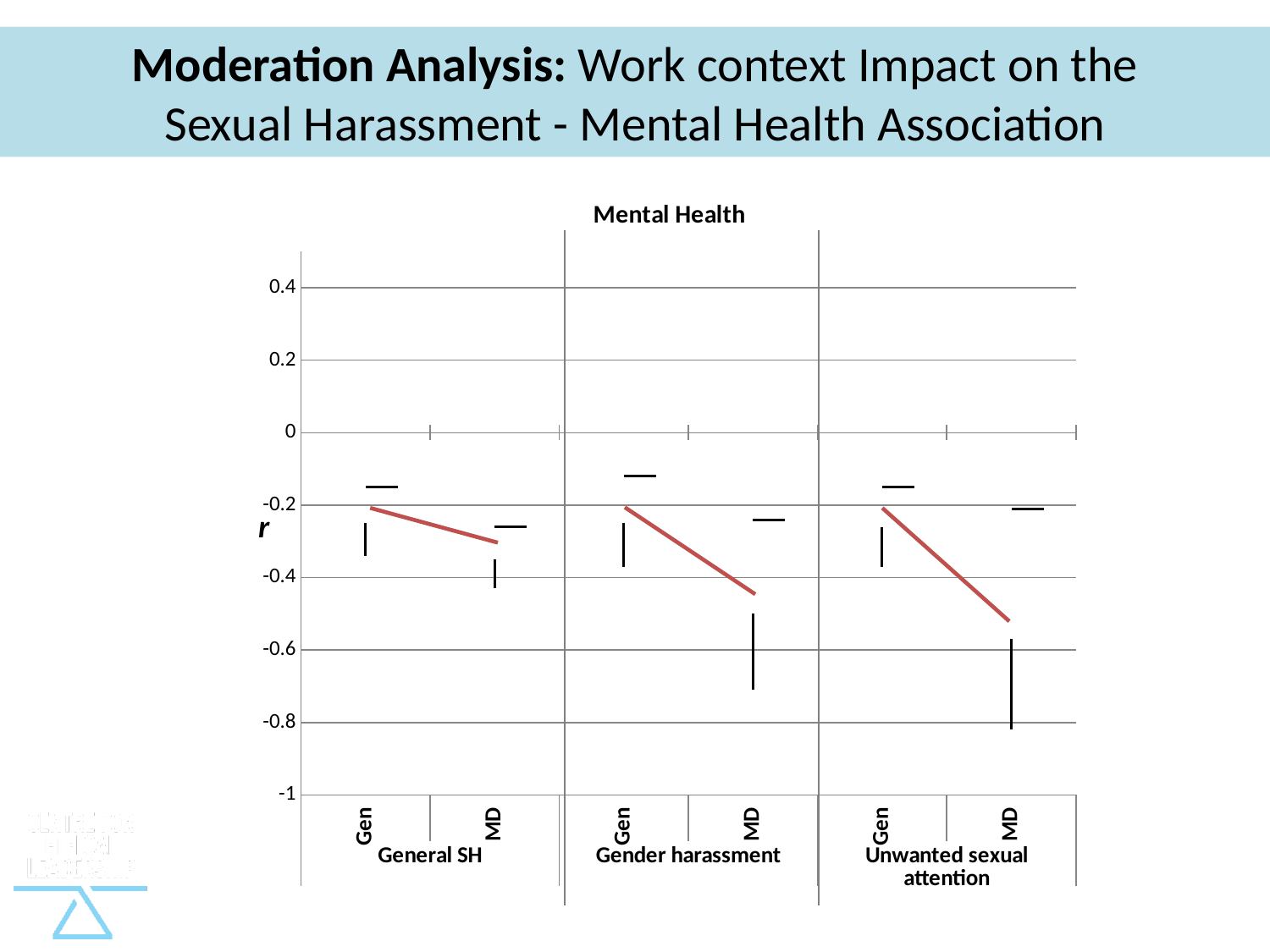
How many plotted points are there in total across all panels? 6 Across the three panels, which category has the lowest MD value? Unwanted sexual attention In the General SH panel, is the value for MD greater or less than -0.4? greater What is the title of the chart? Mental Health In the Gender harassment panel, is the value for MD greater or less than -0.4? less Which is larger: the MD value for General SH or the MD value for Gender harassment? General SH What kind of chart is shown on the slide? line chart How many harassment categories (panels) are shown along the x axis? 3 In the Unwanted sexual attention panel, does the value rise or fall from Gen to MD? fall In the Unwanted sexual attention panel, is the value for MD greater or less than -0.4? less What label is shown on the vertical axis of the chart? r